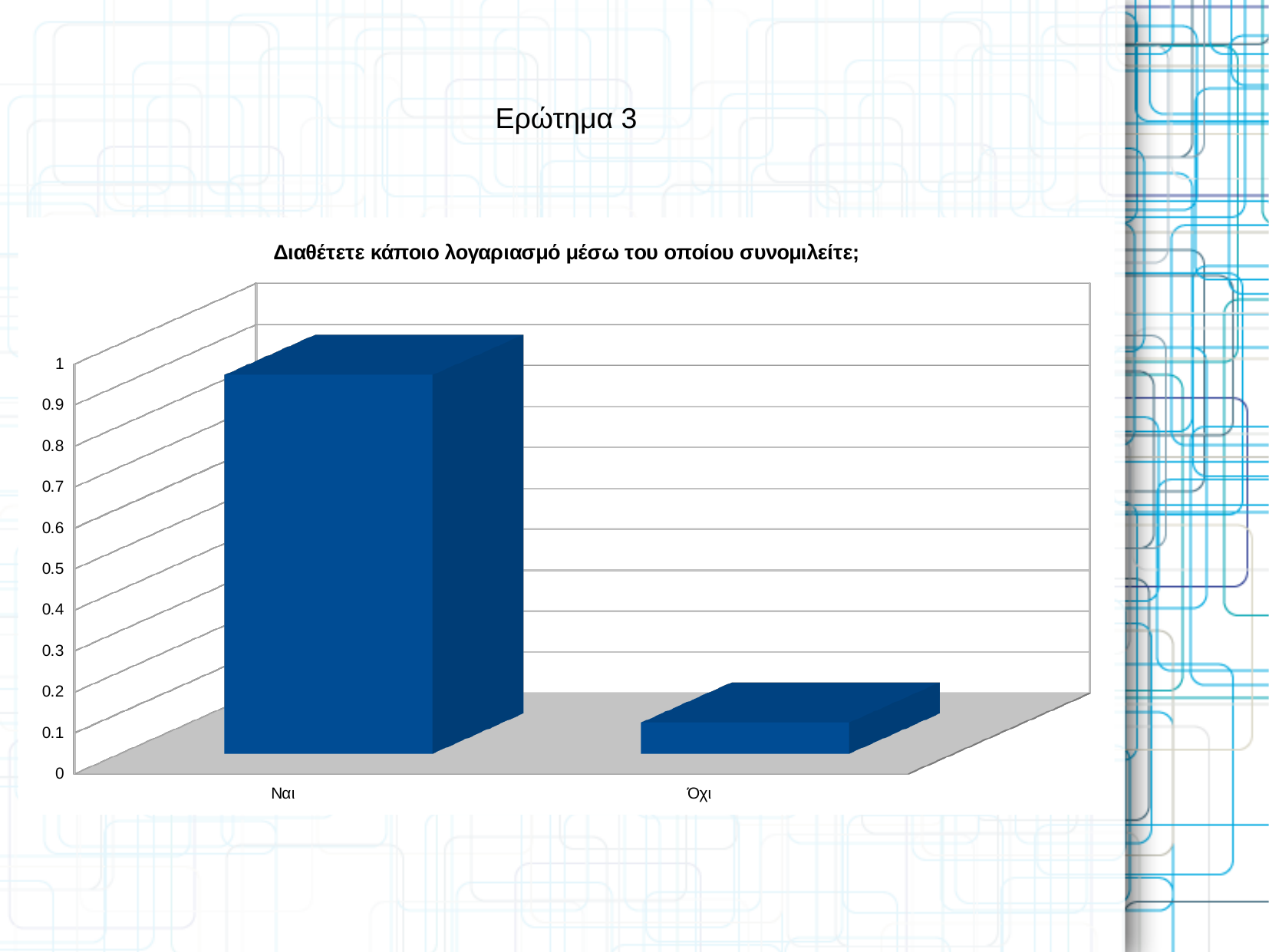
How many categories are shown on the x axis of the chart? 2 Which category has the highest value in the chart? Ναι Which is larger, the value for Ναι or the value for Όχι? Ναι What kind of chart is shown on the slide? bar chart What colour are the bars in the chart? blue Which category has the lowest value in the chart? Όχι Is the value for Όχι greater or less than 0.3? less What is the title of the chart? Διαθέτετε κάποιο λογαριασμό μέσω του οποίου συνομιλείτε; Is the value for Όχι greater or less than 0.5? less Is the value for Ναι greater or less than 0.8? greater